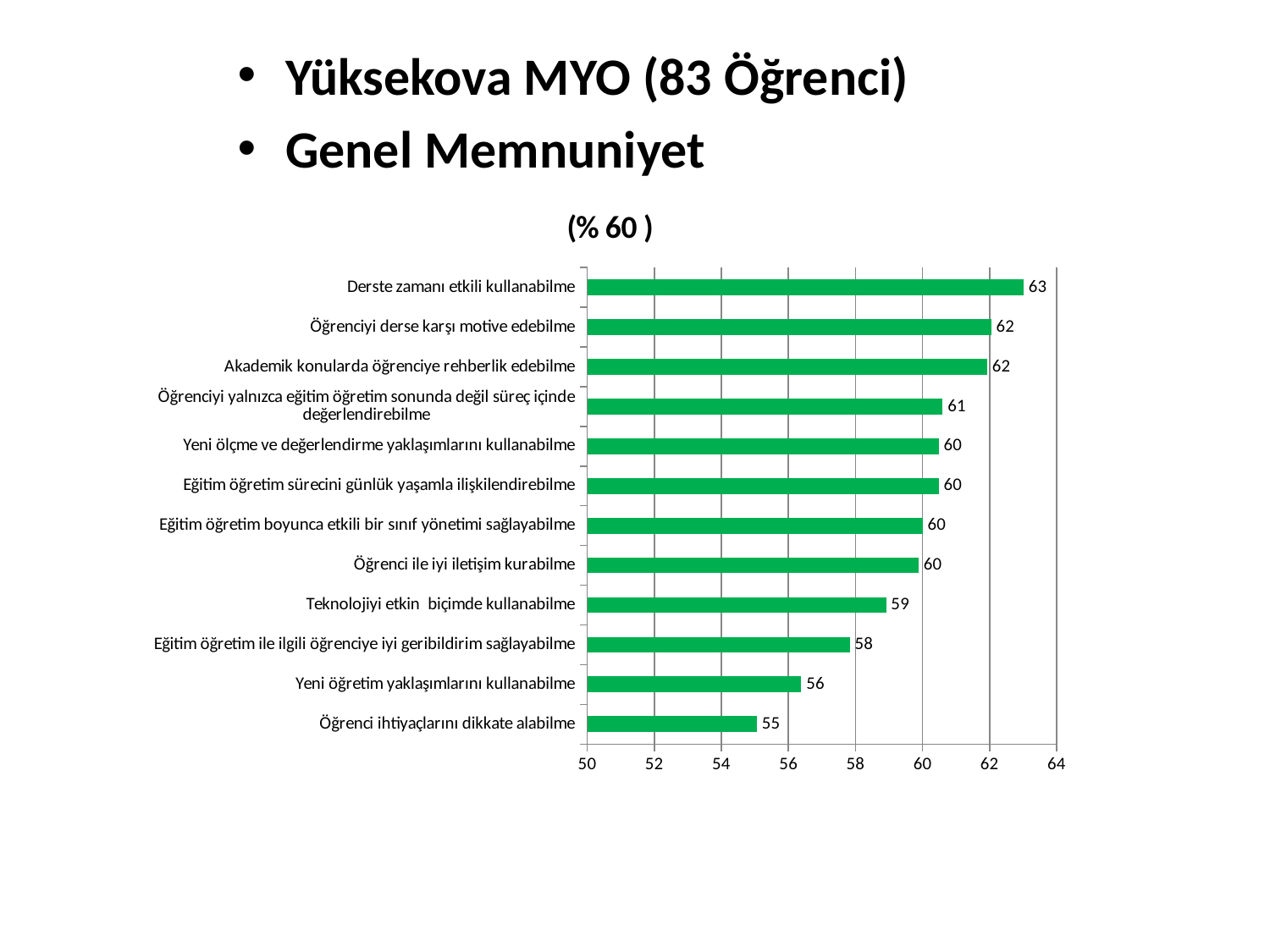
What is the value for "Derste zamanı etkili kullanabilme"? 63 How many categories are plotted in the chart? 12 What is the value for "Teknolojiyi etkin biçimde kullanabilme"? 59 Which is larger: the value for "Eğitim öğretim ile ilgili öğrenciye iyi geribildirim sağlayabilme" or the value for "Yeni öğretim yaklaşımlarını kullanabilme"? Eğitim öğretim ile ilgili öğrenciye iyi geribildirim sağlayabilme What is the title of the chart? (% 60 ) What is the value for "Öğrenci ihtiyaçlarını dikkate alabilme"? 55 What kind of chart is shown on the slide? bar chart Which category has the highest value? Derste zamanı etkili kullanabilme Is the value for "Öğrenciyi derse karşı motive edebilme" greater or less than 60? greater What is the value for "Yeni öğretim yaklaşımlarını kullanabilme"? 56 Which category has the lowest value? Öğrenci ihtiyaçlarını dikkate alabilme What is the difference between the values for "Derste zamanı etkili kullanabilme" and "Öğrenci ihtiyaçlarını dikkate alabilme"? 8